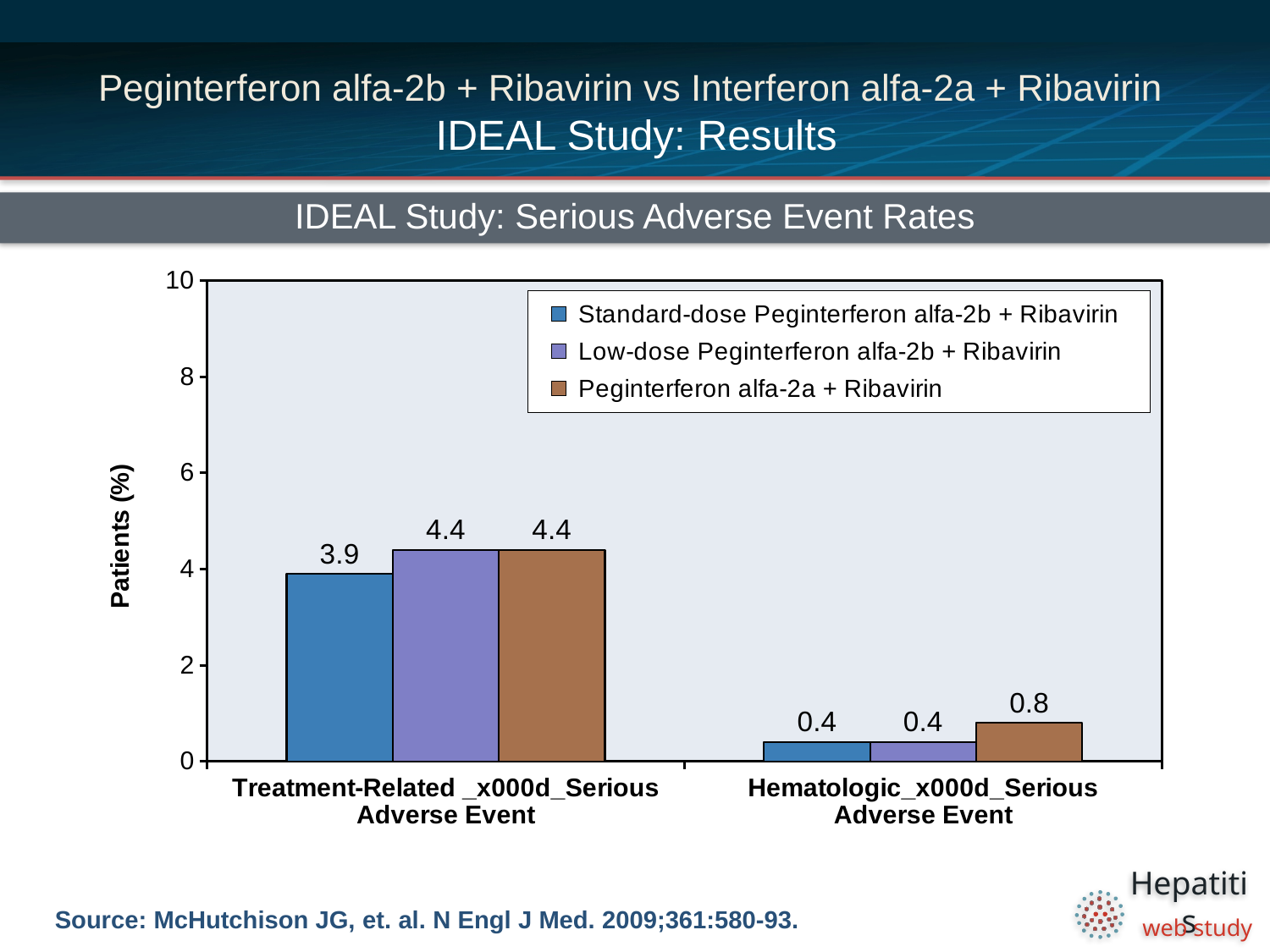
What is the value for Low-dose Peginterferon alfa-2b + Ribavirin for Treatment-Related Serious Adverse Event? 4.4 Which series has the highest value for Hematologic Serious Adverse Event? Peginterferon alfa-2a + Ribavirin What is the difference between the Low-dose Peginterferon alfa-2b + Ribavirin and Standard-dose Peginterferon alfa-2b + Ribavirin values for Treatment-Related Serious Adverse Event? 0.5 How many series does the legend list? 3 What is the value for Peginterferon alfa-2a + Ribavirin for Hematologic Serious Adverse Event? 0.8 What kind of chart is shown on the slide? Bar chart What is the label of the y axis? Patients (%) What is the difference between the Peginterferon alfa-2a + Ribavirin values for Treatment-Related Serious Adverse Event and Hematologic Serious Adverse Event? 3.6 What is the value for Standard-dose Peginterferon alfa-2b + Ribavirin for Treatment-Related Serious Adverse Event? 3.9 What is the value for Low-dose Peginterferon alfa-2b + Ribavirin for Hematologic Serious Adverse Event? 0.4 Which is larger: the Peginterferon alfa-2a + Ribavirin value for Hematologic Serious Adverse Event or the Standard-dose Peginterferon alfa-2b + Ribavirin value for Hematologic Serious Adverse Event? Peginterferon alfa-2a + Ribavirin Which series has the lowest value for Treatment-Related Serious Adverse Event? Standard-dose Peginterferon alfa-2b + Ribavirin